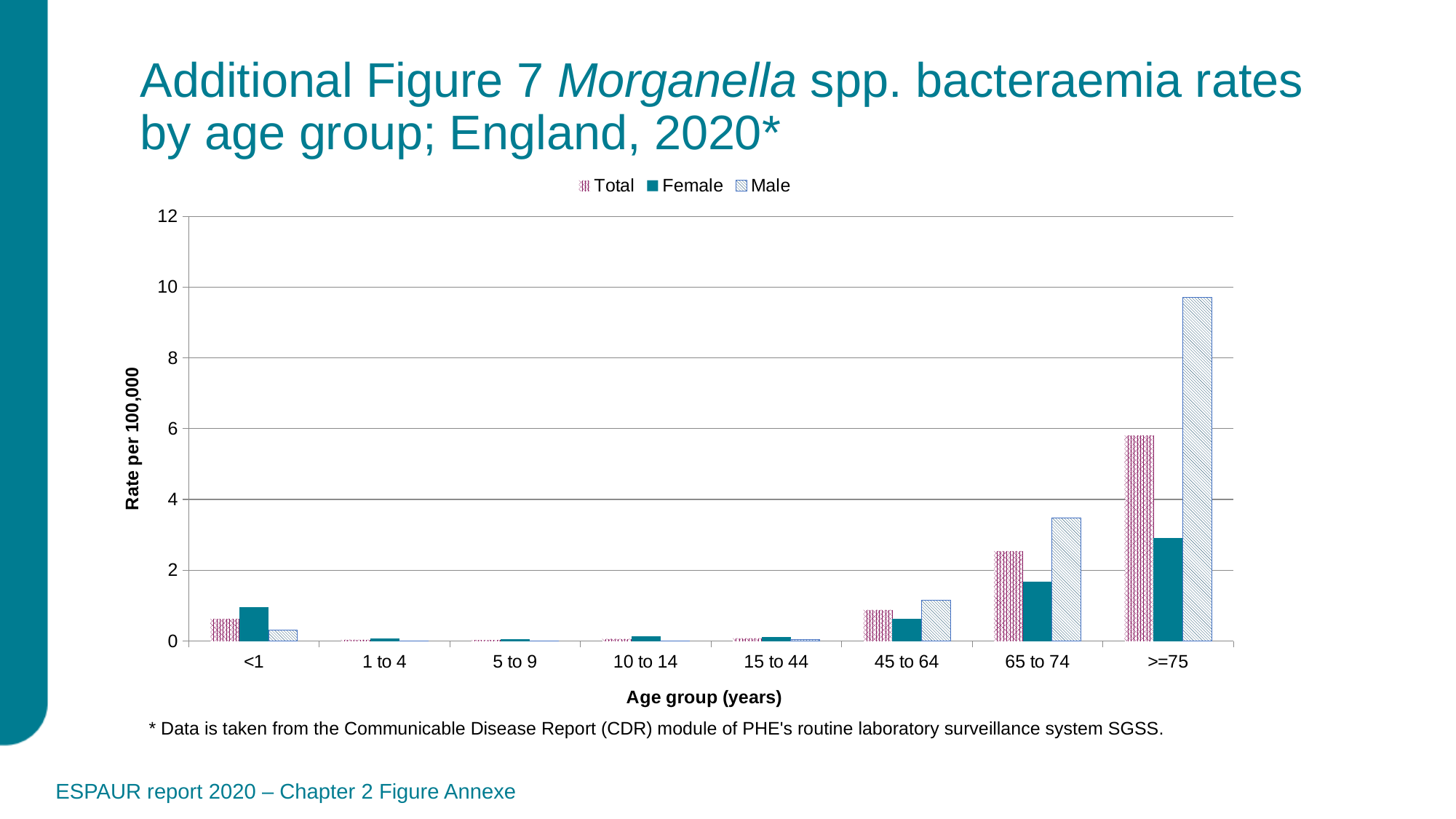
In the <1 age group, which is larger, the Female rate or the Male rate? Female What is the title of the y axis? Rate per 100,000 How many series does the legend list? 3 In the >=75 age group, which is larger, the Male rate or the Female rate? Male Is the Total value for the 65 to 74 age group greater or less than 2? greater Is the Male value for the 65 to 74 age group greater or less than 4? less Is the Male value for the >=75 age group greater or less than 8? greater How many age groups are shown on the x axis? 8 Which age group has the highest Male bacteraemia rate? >=75 What kind of chart is shown on the slide? bar chart What is the title of the x axis? Age group (years)